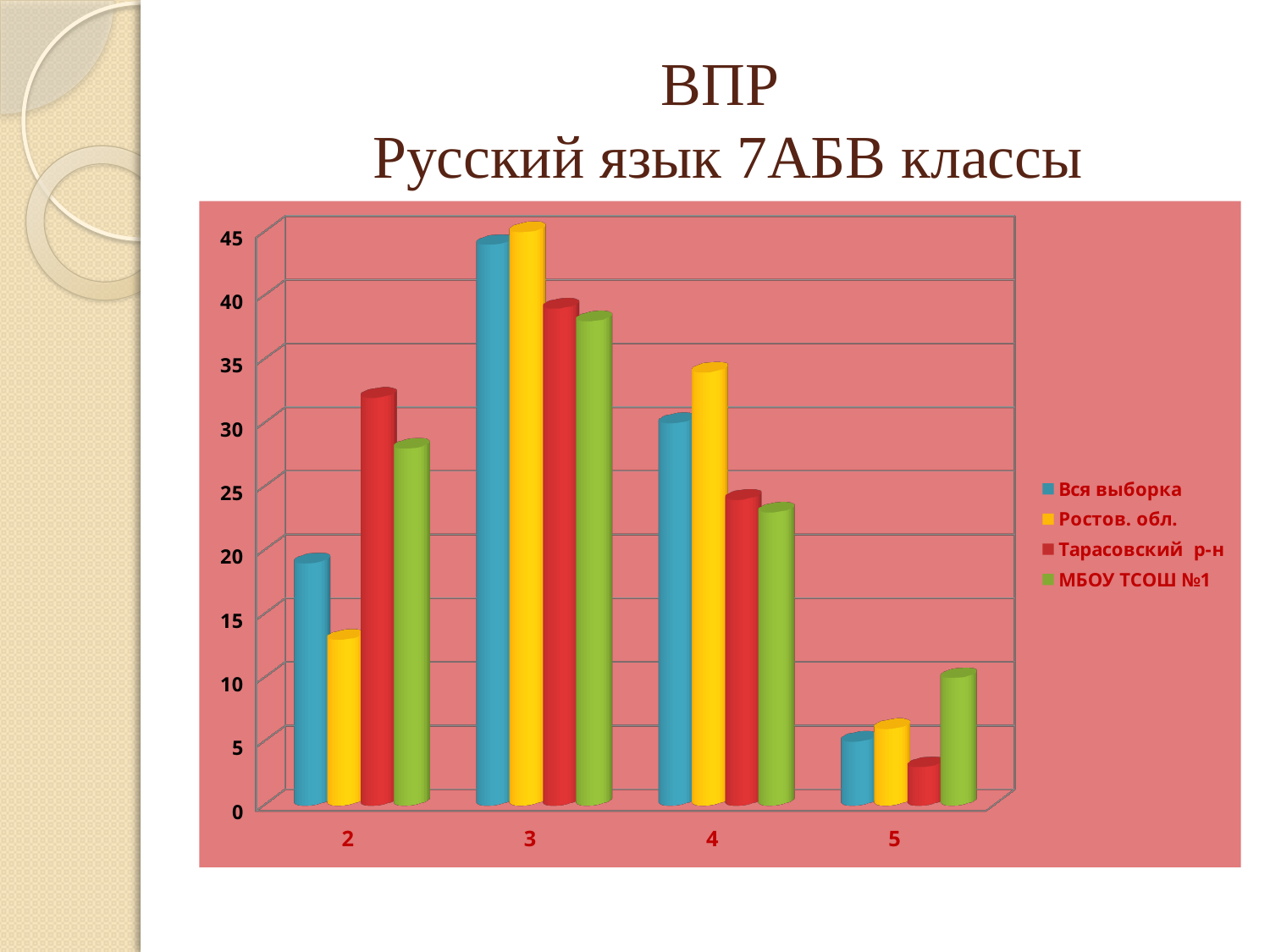
Which series has the lowest value for category 2? Ростов. обл. For the series МБОУ ТСОШ №1, which category has the lowest value? 5 Is the value for Тарасовский р-н in category 2 greater or less than 30? greater How many series does the legend list? 4 For category 4, which is larger: Ростов. обл. or Тарасовский р-н? Ростов. обл. Is the value for Тарасовский р-н in category 5 greater or less than 5? less What is the title of the slide containing the chart? ВПР Русский язык 7АБВ классы What kind of chart is shown on the slide? bar chart Which series has the highest value for category 2? Тарасовский р-н How many categories are shown on the x axis? 4 Which series has the highest value for category 5? МБОУ ТСОШ №1 For the series Тарасовский р-н, which category has the highest value? 3